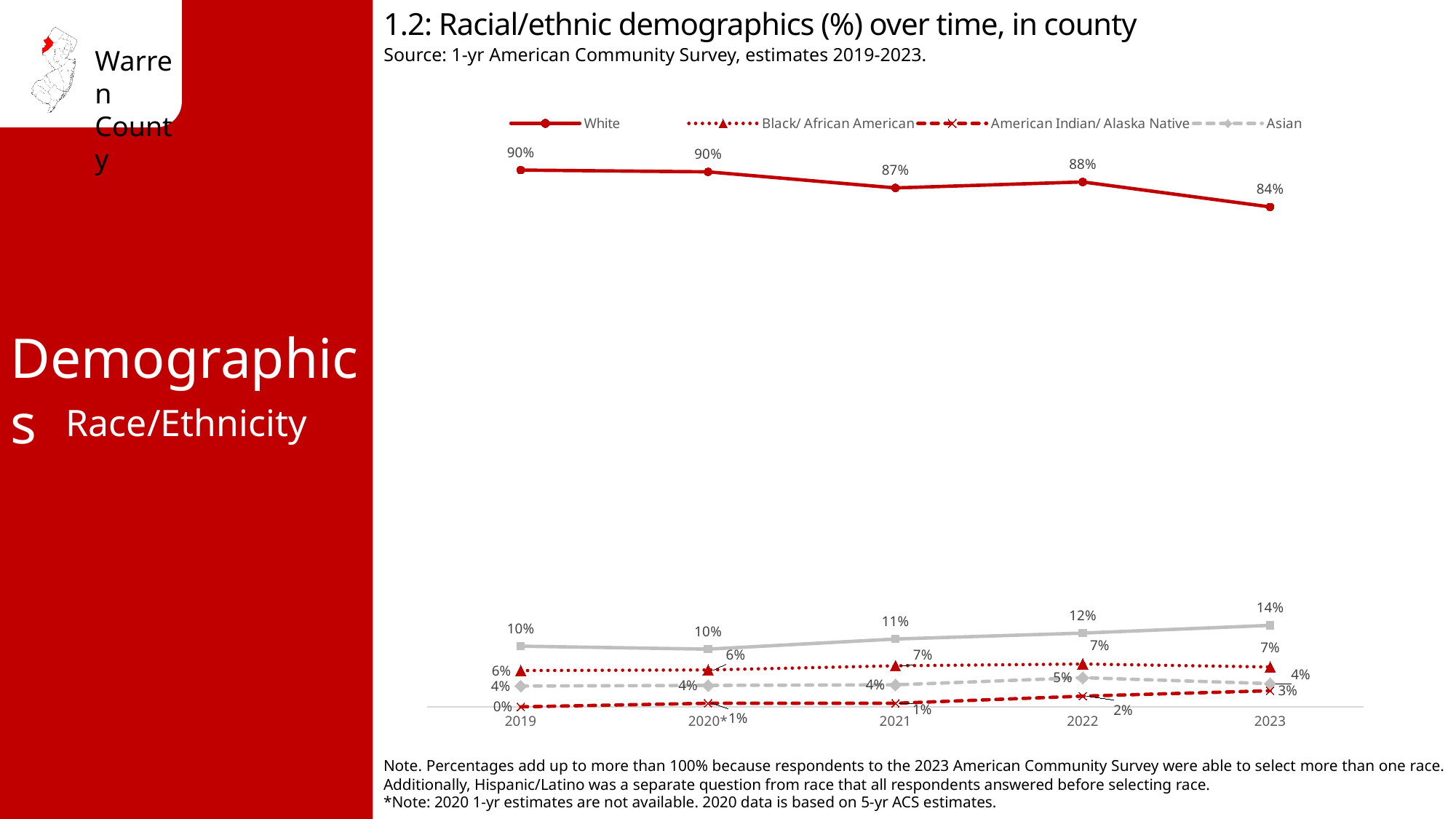
What was the American Indian/ Alaska Native percentage in 2023? 3% Which was larger in 2023, the Black/ African American percentage or the Asian percentage? Black/ African American How many years are shown on the x axis? 5 What kind of chart is shown on the slide? Line chart What was the Asian percentage in 2022? 5% What was the Black/ African American percentage in 2021? 7% What was the White percentage in 2023? 84% In which year was the American Indian/ Alaska Native percentage highest? 2023 Does the White percentage generally rise or fall from 2019 to 2023? Fall By how many percentage points did the White percentage fall from 2019 to 2023? 6 What was the White percentage in 2019? 90% In which year was the White percentage lowest? 2023